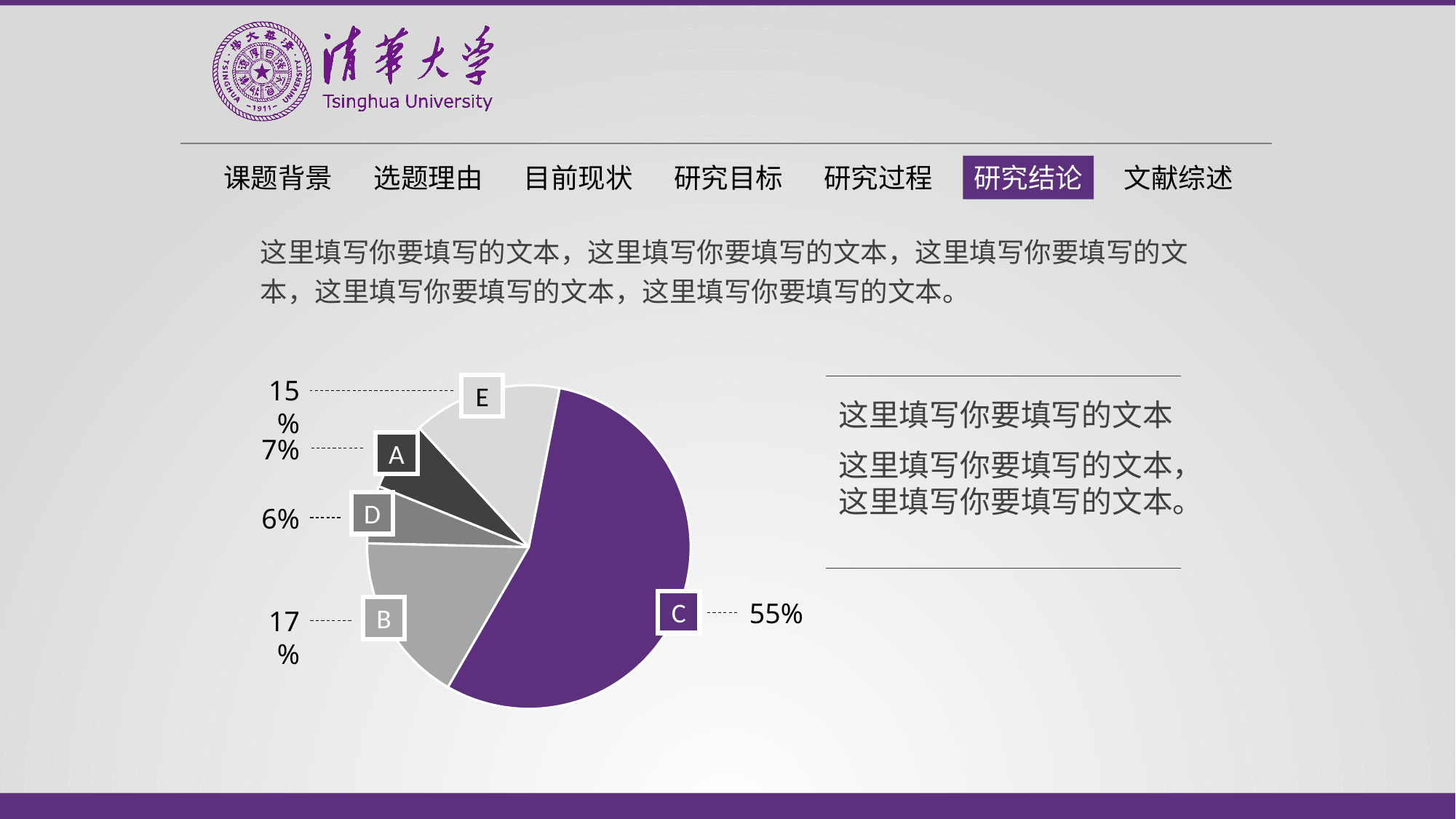
Which slice is larger, B or E? B Which slice of the pie chart is the largest? C What percentage does slice B represent in the pie chart? 17% What percentage does slice E represent in the pie chart? 15% How many slices does the pie chart have? 5 What percentage does slice D represent in the pie chart? 6% What percentage does slice C represent in the pie chart? 55% What colour is slice C in the pie chart? purple What kind of chart is shown on the slide? pie chart What is the difference in percentage points between slice C and slice B? 38 What percentage does slice A represent in the pie chart? 7% Which slice of the pie chart is the smallest? D